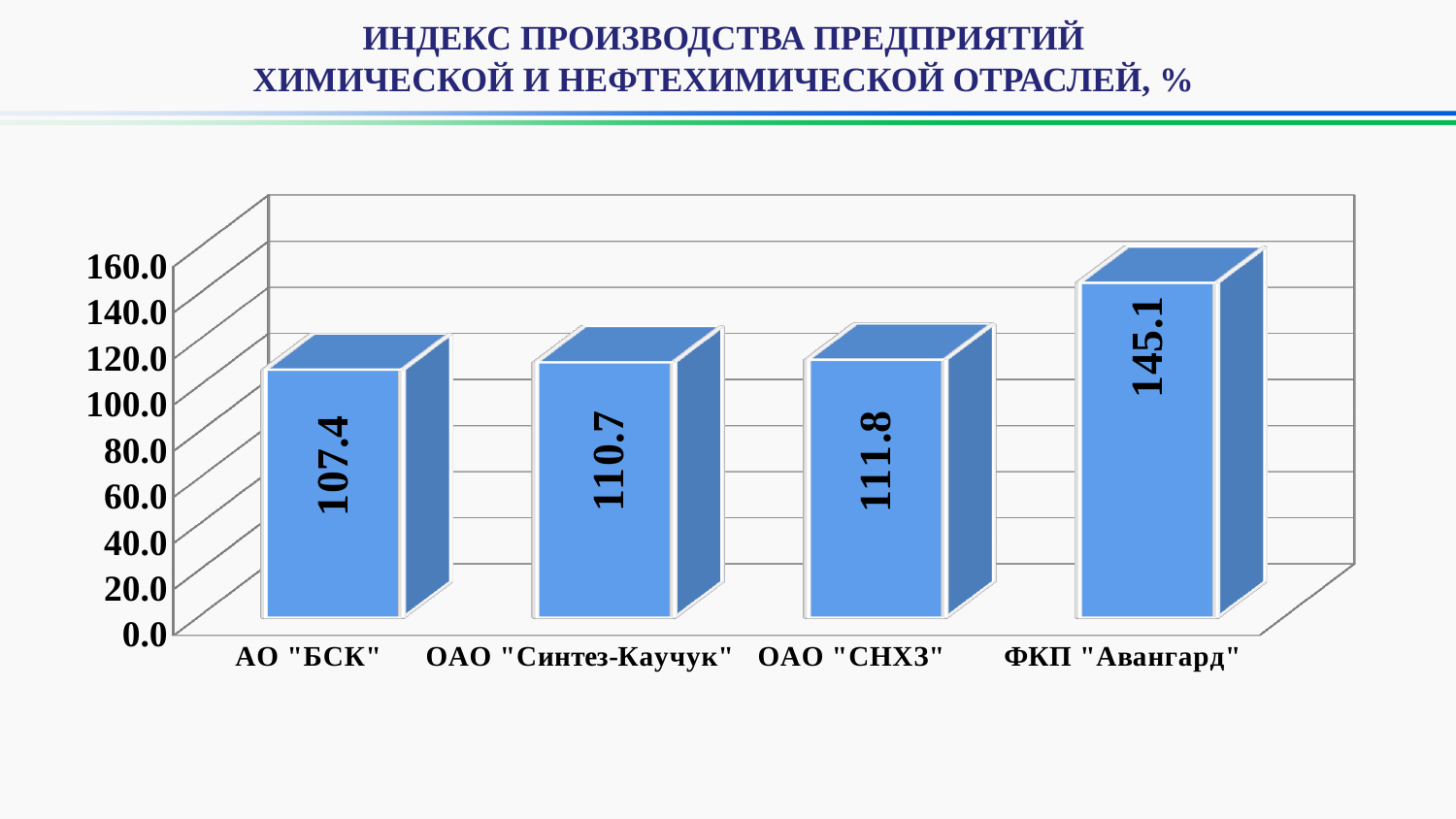
What is the title of the chart? ИНДЕКС ПРОИЗВОДСТВА ПРЕДПРИЯТИЙ ХИМИЧЕСКОЙ И НЕФТЕХИМИЧЕСКОЙ ОТРАСЛЕЙ, % What is the difference between the production index of ОАО "СНХЗ" and ОАО "Синтез-Каучук"? 1.1 What is the production index value for АО "БСК"? 107.4 What is the difference between the production index of ФКП "Авангард" and АО "БСК"? 37.7 What is the production index value for ОАО "Синтез-Каучук"? 110.7 What kind of chart is shown on the slide? Bar chart Which has a larger production index, ОАО "Синтез-Каучук" or ФКП "Авангард"? ФКП "Авангард" Which enterprise has the highest production index? ФКП "Авангард" What is the production index value for ФКП "Авангард"? 145.1 What is the production index value for ОАО "СНХЗ"? 111.8 Which enterprise has the lowest production index? АО "БСК" How many enterprises are shown in the chart? 4